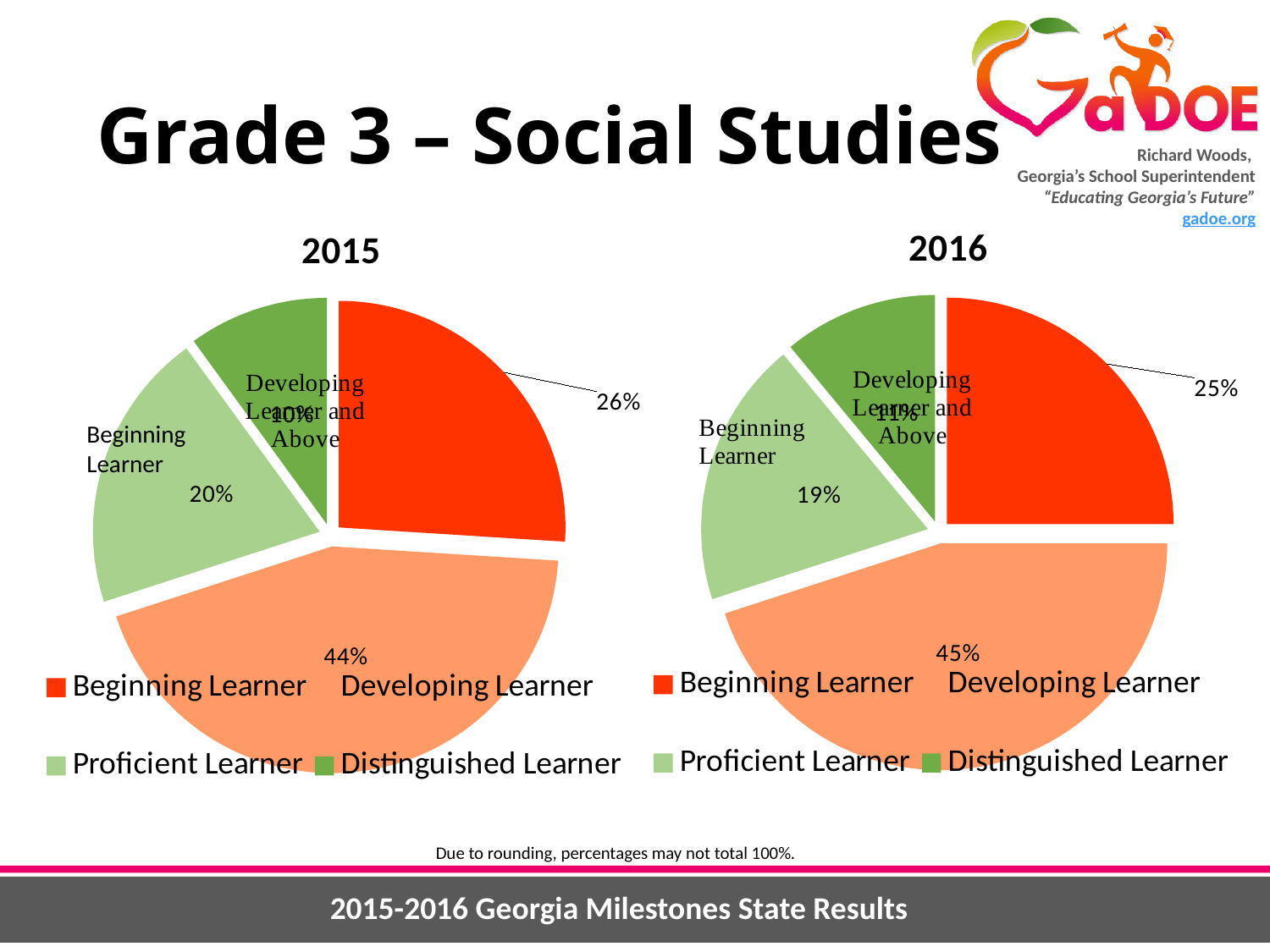
How many entries does the legend of the 2015 chart list? 4 In the 2016 chart, which category has the smallest slice? Distinguished Learner In the 2016 chart, what percentage is shown for Beginning Learner? 25% In the 2015 chart, what percentage is shown for Beginning Learner? 26% In the 2016 chart, what percentage is shown for Proficient Learner? 19% How many slices does the 2016 pie chart have? 4 In the 2015 chart, which category has the largest slice? Developing Learner What is the title of the chart on the right? 2016 Which is larger in the 2015 chart: the Beginning Learner slice or the Proficient Learner slice? Beginning Learner In the 2015 chart, what percentage is shown for Developing Learner? 44% What kind of chart is the 2015 chart? pie chart What is the difference between the Developing Learner percentage in the 2016 chart and in the 2015 chart? 1%